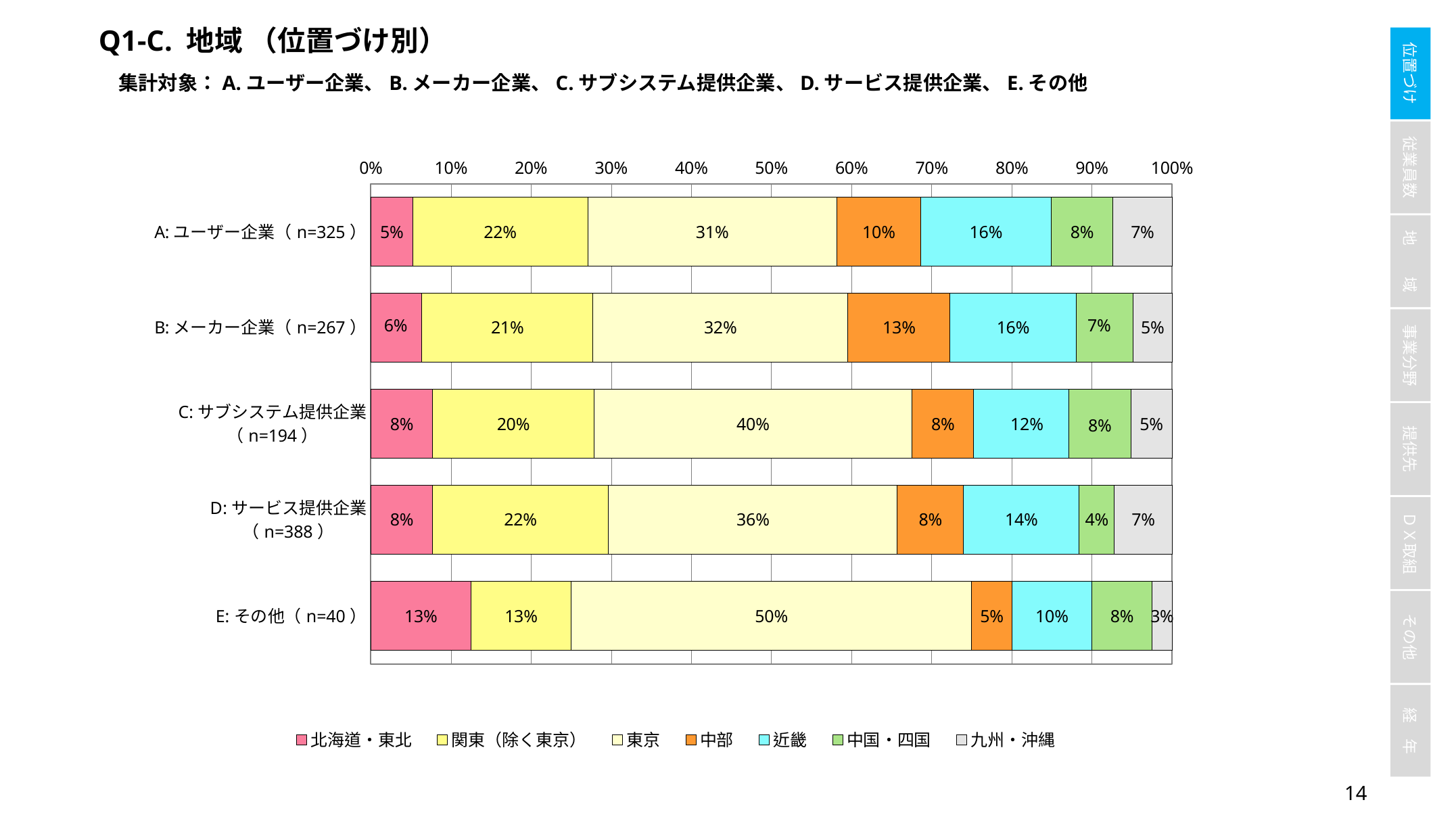
What is the 東京 share for C: サブシステム提供企業 (n=194)? 40% How many series does the legend list? 7 What is the 近畿 share for A: ユーザー企業 (n=325)? 16% Which category has the lowest 中国・四国 share? D: サービス提供企業 (n=388) Which legend entry is shown in orange? 中部 What is the difference between the 東京 share for D: サービス提供企業 and for A: ユーザー企業? 5% What is the 九州・沖縄 share for E: その他 (n=40)? 3% Which is larger: the 北海道・東北 share for E: その他 or for B: メーカー企業? E: その他 Which category has the highest 東京 share? E: その他 (n=40) How many categories (bars) are shown in the chart? 5 What kind of chart is shown on the slide? Stacked bar chart What is the 中部 share for B: メーカー企業 (n=267)? 13%